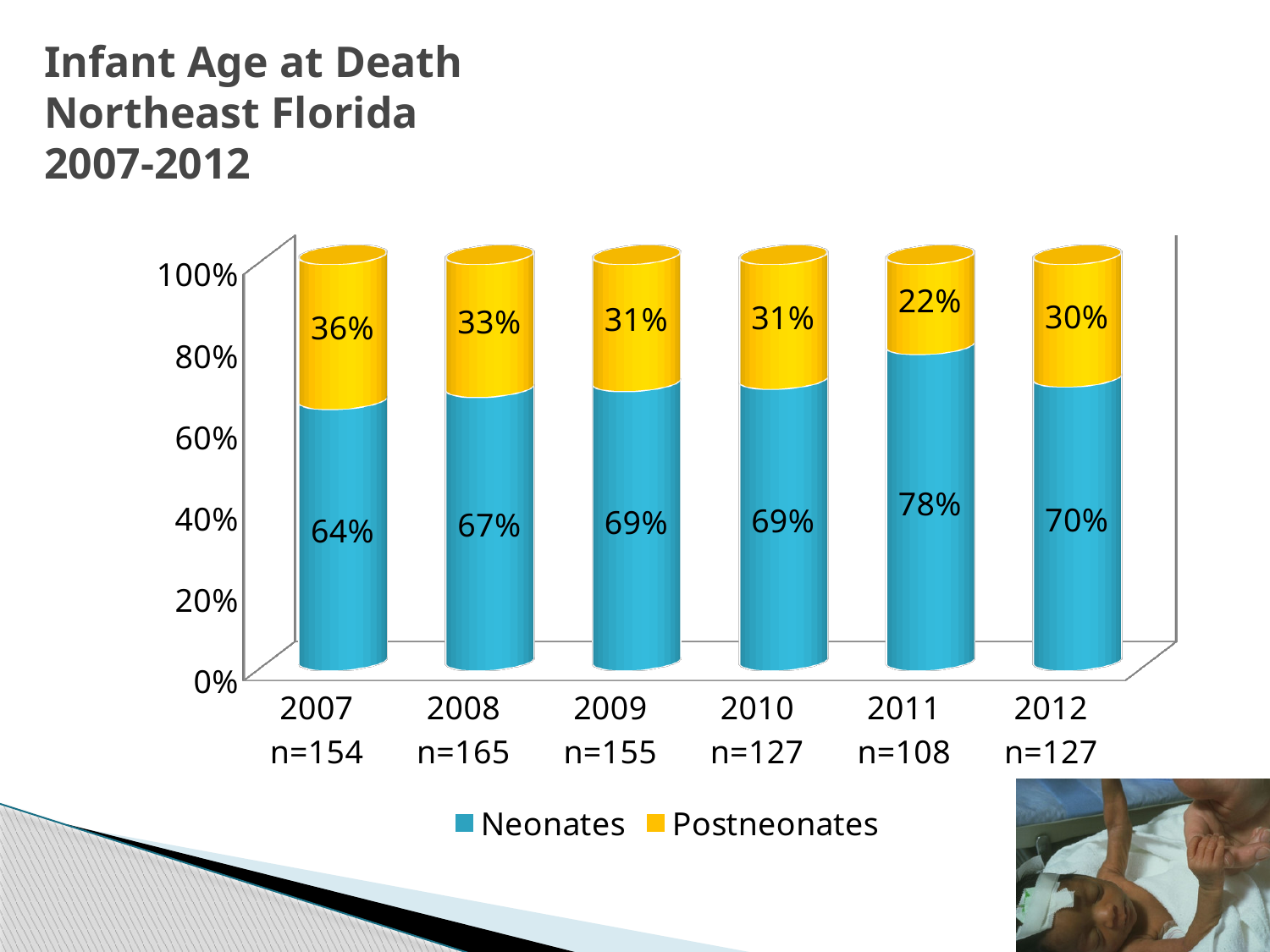
What percentage of infant deaths were Postneonates in 2007? 36% What is the total of the stacked bar for 2009? 100% Is the Postneonates percentage larger in 2008 or in 2012? 2008 What kind of chart is shown on the slide? Stacked bar chart Which year has the highest Neonates percentage? 2011 What percentage of infant deaths were Neonates in 2011? 78% What is the sample size (n) shown for 2008? n=165 Which year has the lowest Postneonates percentage? 2011 What is the Neonates value for 2012? 70% What is the difference between the Neonates percentage in 2011 and in 2007? 14% How many years are shown on the x axis? 6 How many series does the legend list? 2